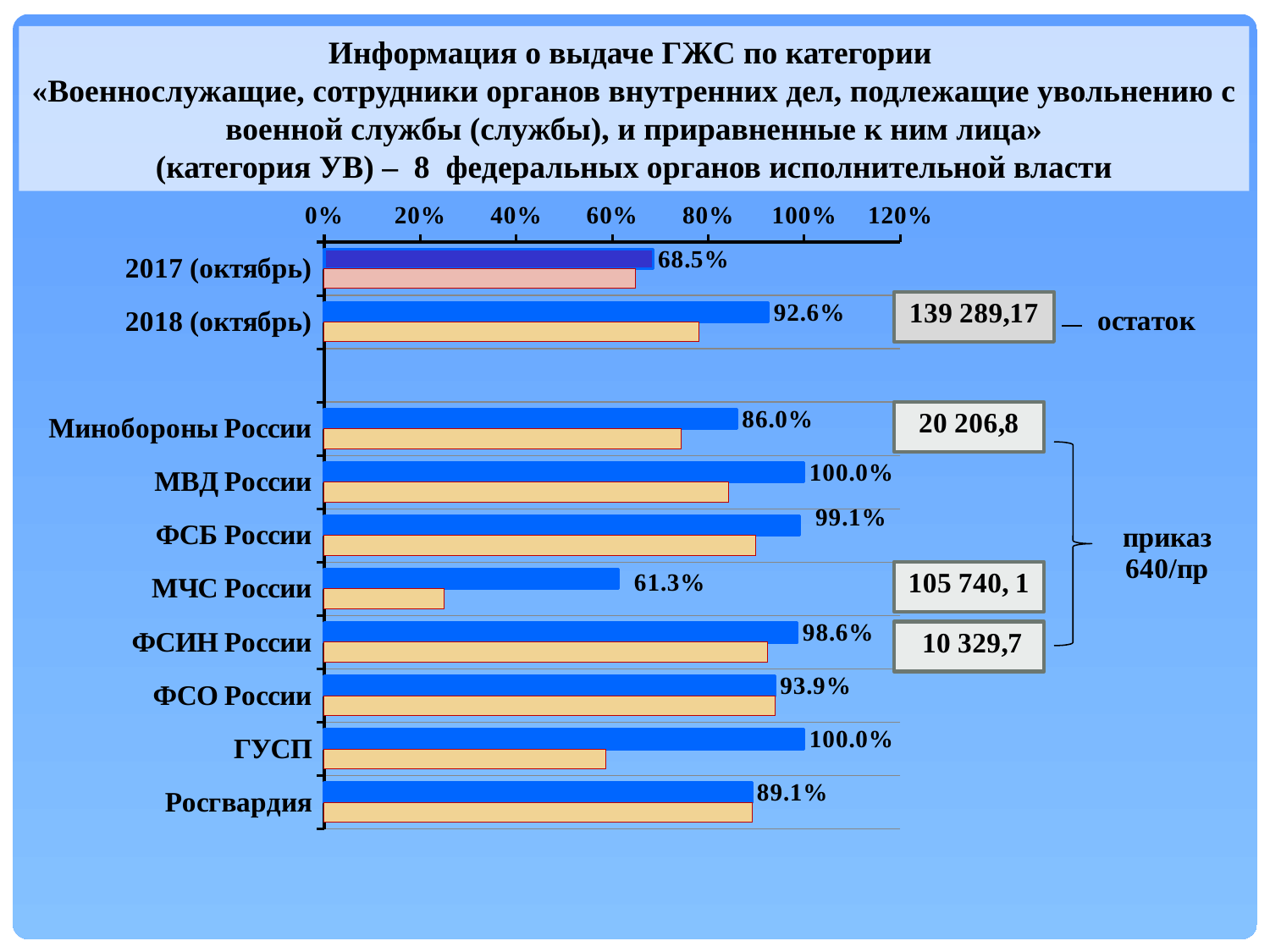
What is the labelled value for МЧС России? 61.3% What is the labelled value for 2018 (октябрь)? 92.6% What is the difference in percentage points between the labelled values for МВД России and МЧС России? 38.7 What value is shown in the box labelled "остаток" next to the 2018 (октябрь) bar? 139 289,17 What is the difference in percentage points between the labelled values for 2018 (октябрь) and 2017 (октябрь)? 24.1 What is the labelled value for Росгвардия? 89.1% How many categories are listed on the vertical axis of the chart? 10 What kind of chart is shown on the slide? bar chart Which category has the lowest labelled percentage? МЧС России What is the labelled value for Минобороны России? 86.0% Which has the larger labelled value, ФСО России or Росгвардия? ФСО России Is the value of the lower (beige) bar for МЧС России greater or less than 40%? less